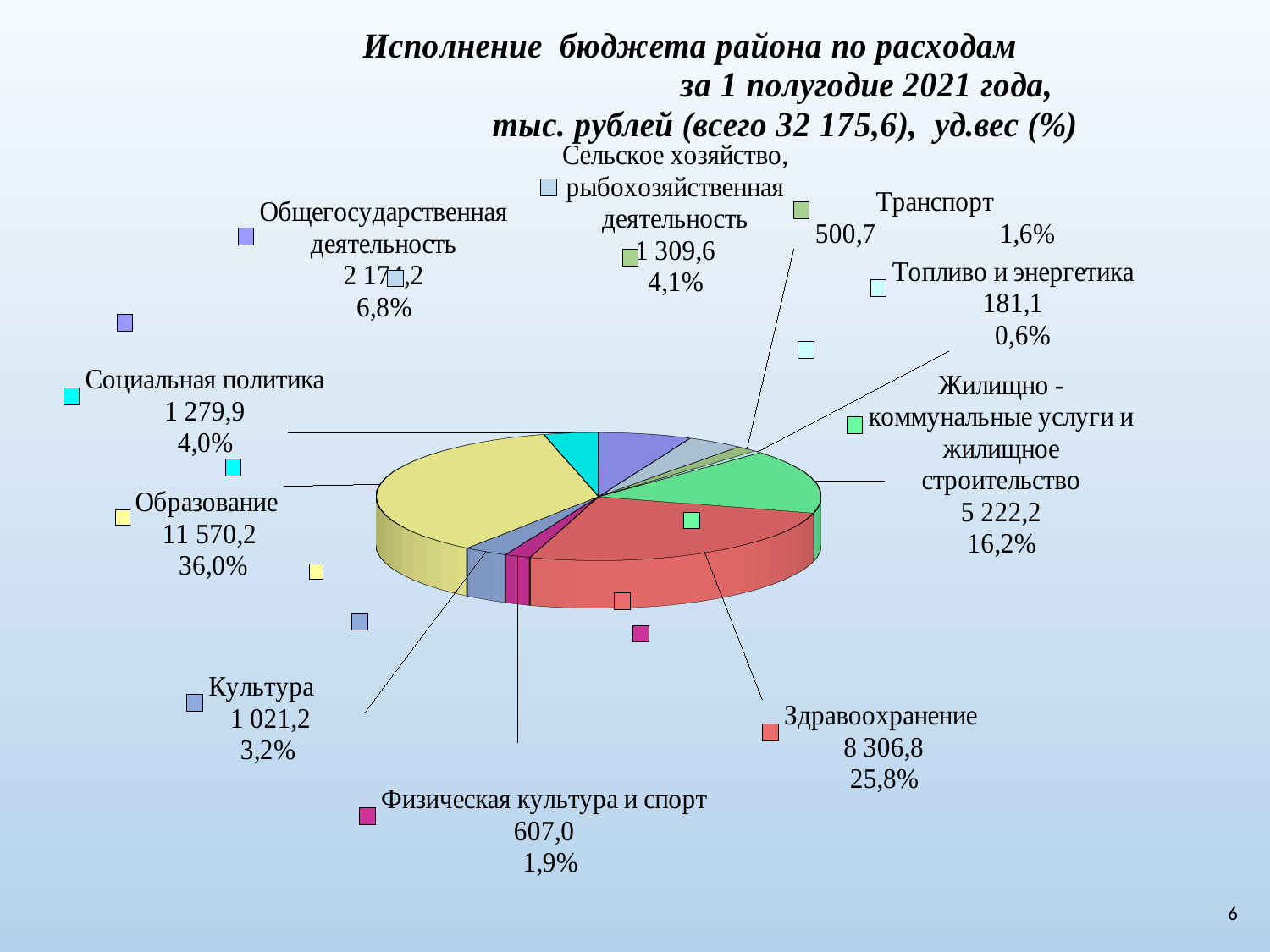
What is the value for Жилищно-коммунальные услуги и жилищное строительство? 5 222,2 Which category has the smallest slice? Топливо и энергетика What share of the pie does Здравоохранение have? 25,8% What is the difference between the values for Здравоохранение and Жилищно-коммунальные услуги и жилищное строительство? 3 084,6 How many categories (slices) does the pie chart show? 10 What total amount is stated in the chart title? 32 175,6 What kind of chart is shown on the slide? pie chart What share of the pie does Топливо и энергетика have? 0,6% Which category has the largest slice? Образование What is the value for Физическая культура и спорт? 607,0 Which is larger, Культура or Социальная политика? Социальная политика What is the value for Образование? 11 570,2